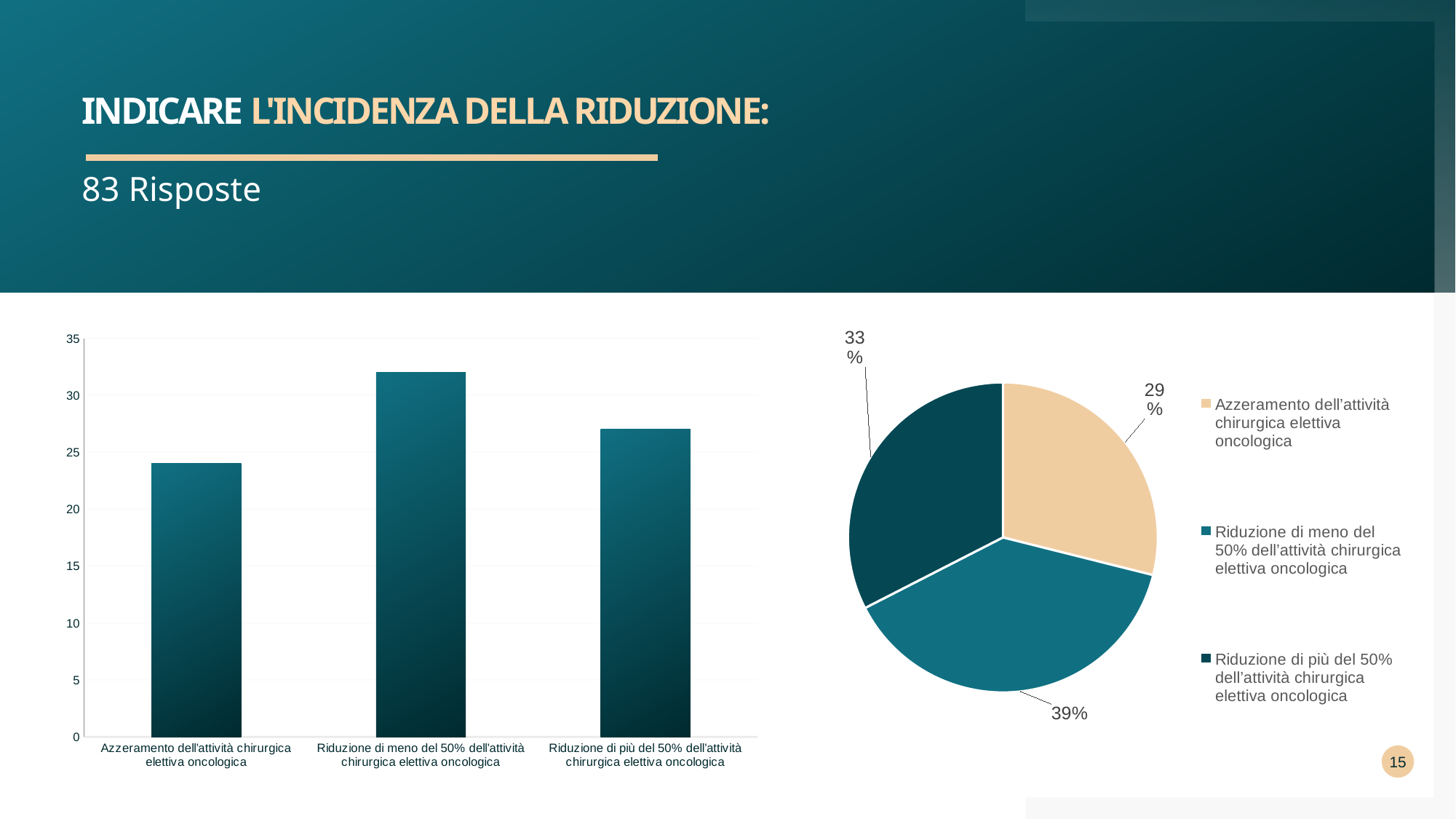
In the bar chart on the left, is the value for Riduzione di più del 50% dell'attività chirurgica elettiva oncologica greater or less than 30? less In the pie chart on the right, what share does Azzeramento dell'attività chirurgica elettiva oncologica have? 29% In the bar chart on the left, how many categories are shown? 3 In the bar chart on the left, is the value for Azzeramento dell'attività chirurgica elettiva oncologica greater or less than 20? greater What kind of chart is the chart on the right of the slide? pie chart In the bar chart on the left, which category has the lowest bar? Azzeramento dell'attività chirurgica elettiva oncologica What kind of chart is the chart on the left of the slide? bar chart In the pie chart on the right, what is the difference between the share for Riduzione di meno del 50% and the share for Azzeramento dell'attività chirurgica elettiva oncologica? 10% In the pie chart on the right, what share does Riduzione di meno del 50% dell'attività chirurgica elettiva oncologica have? 39% In the bar chart on the left, which category has the highest bar? Riduzione di meno del 50% dell'attività chirurgica elettiva oncologica In the bar chart on the left, is the value for Riduzione di meno del 50% dell'attività chirurgica elettiva oncologica greater or less than 30? greater How many entries does the legend of the pie chart on the right list? 3